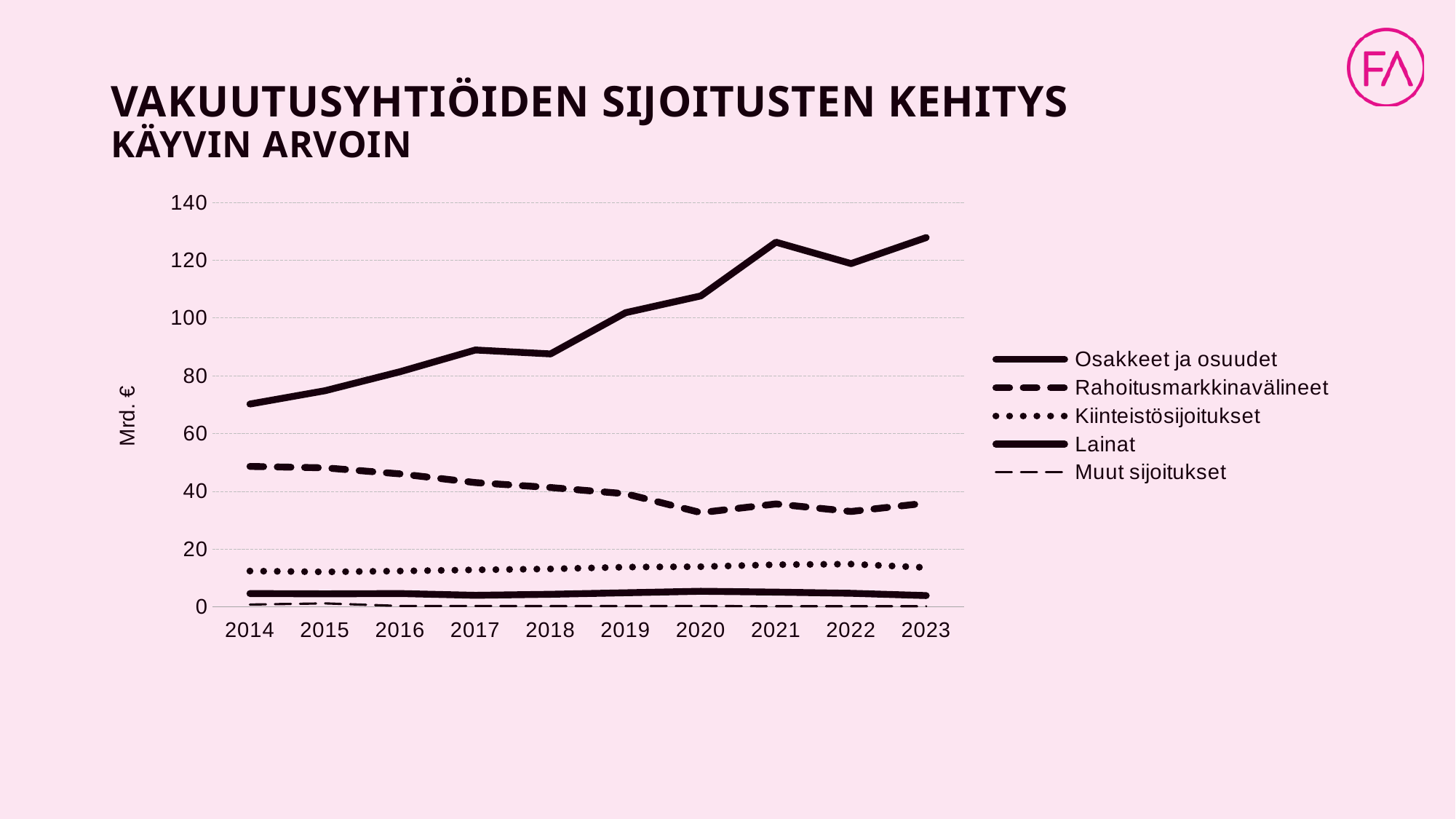
Is the value for Rahoitusmarkkinavälineet in 2014 greater or less than 40? greater Which series has the lowest value in 2023? Muut sijoitukset What kind of chart is shown on the slide? line chart Does the Osakkeet ja osuudet line rise or fall overall from 2014 to 2023? rise Is the value for Osakkeet ja osuudet in 2014 greater or less than 80? less Is the value for Osakkeet ja osuudet in 2023 greater or less than 120? greater Which series has the highest value in 2023? Osakkeet ja osuudet In 2023, which is larger: Kiinteistösijoitukset or Lainat? Kiinteistösijoitukset Does the Rahoitusmarkkinavälineet line rise or fall overall from 2014 to 2023? fall How many series does the legend list? 5 How many years are shown on the x axis? 10